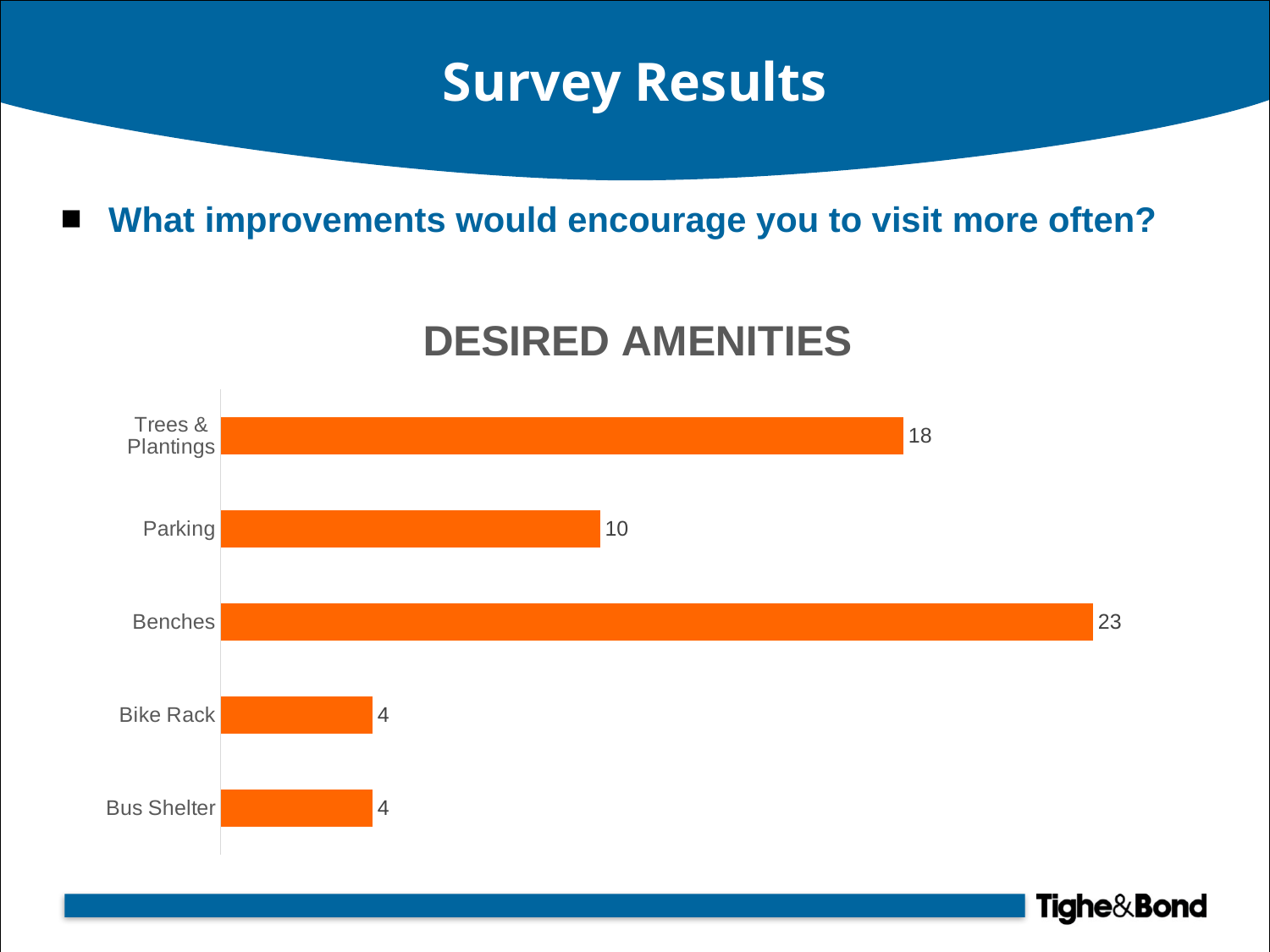
What is the title of the chart? DESIRED AMENITIES What is the value for Parking? 10 What is the value for Bike Rack? 4 What is the value for Benches? 23 What kind of chart is shown on the slide? Bar chart How many categories are shown in the chart? 5 What is the difference between the values for Benches and Trees & Plantings? 5 What is the difference between the values for Trees & Plantings and Parking? 8 Which category has the highest value? Benches What is the value for Trees & Plantings? 18 Which is larger, the value for Parking or the value for Bus Shelter? Parking What colour are the bars in the chart? Orange